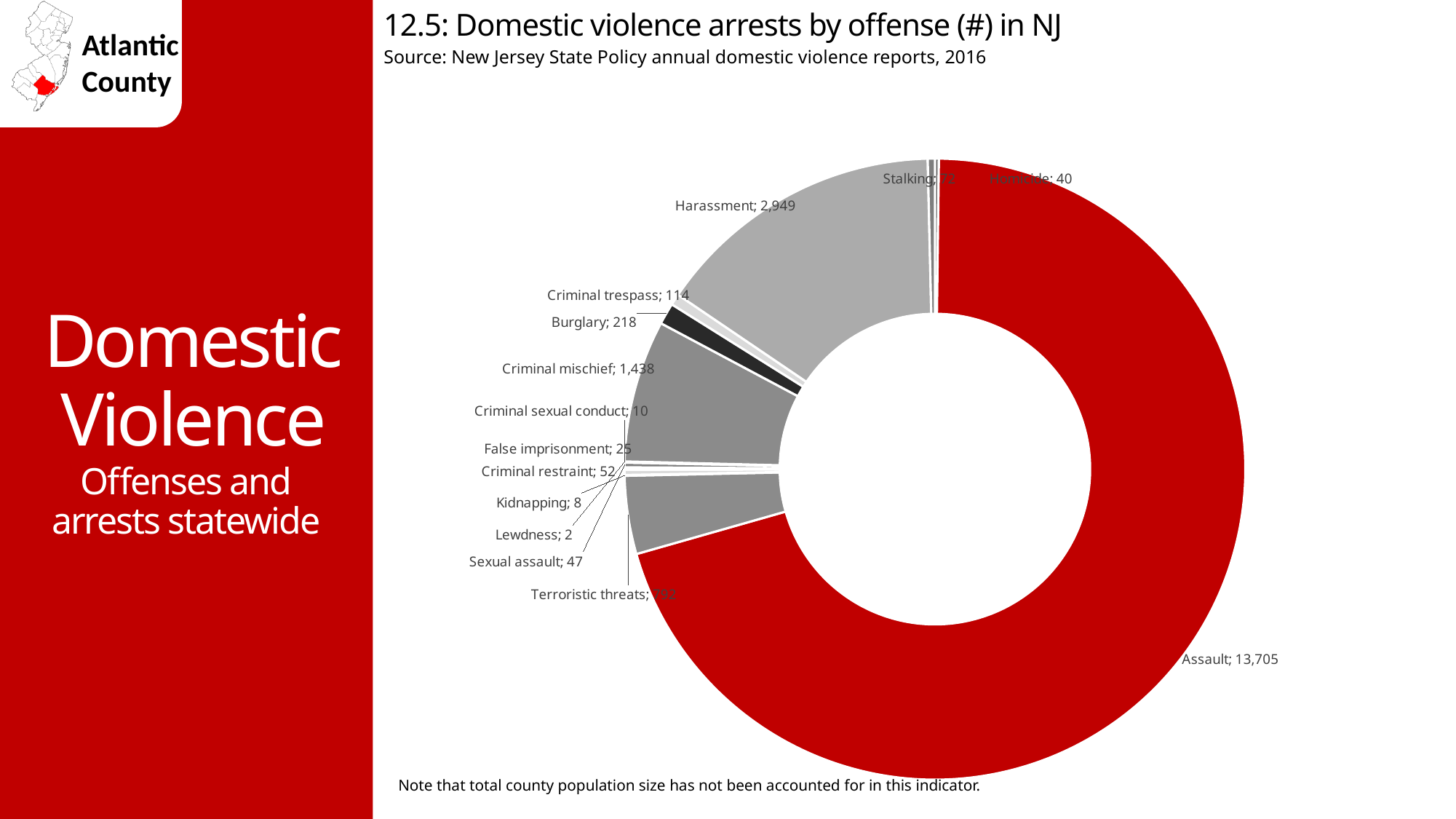
How many offense categories are shown in the chart? 14 How many domestic violence arrests are shown for Criminal mischief? 1,438 What is the difference between the number of arrests for Harassment and for Criminal mischief? 1,511 How many domestic violence arrests are shown for Sexual assault? 47 Which offense has the lowest number of domestic violence arrests? Lewdness What kind of chart is shown on the slide? doughnut chart How many domestic violence arrests are shown for Assault? 13,705 How many domestic violence arrests are shown for Burglary? 218 How many domestic violence arrests are shown for Harassment? 2,949 What is the title of the chart? 12.5: Domestic violence arrests by offense (#) in NJ Which has more arrests, Burglary or Criminal trespass? Burglary Which offense has the highest number of domestic violence arrests? Assault